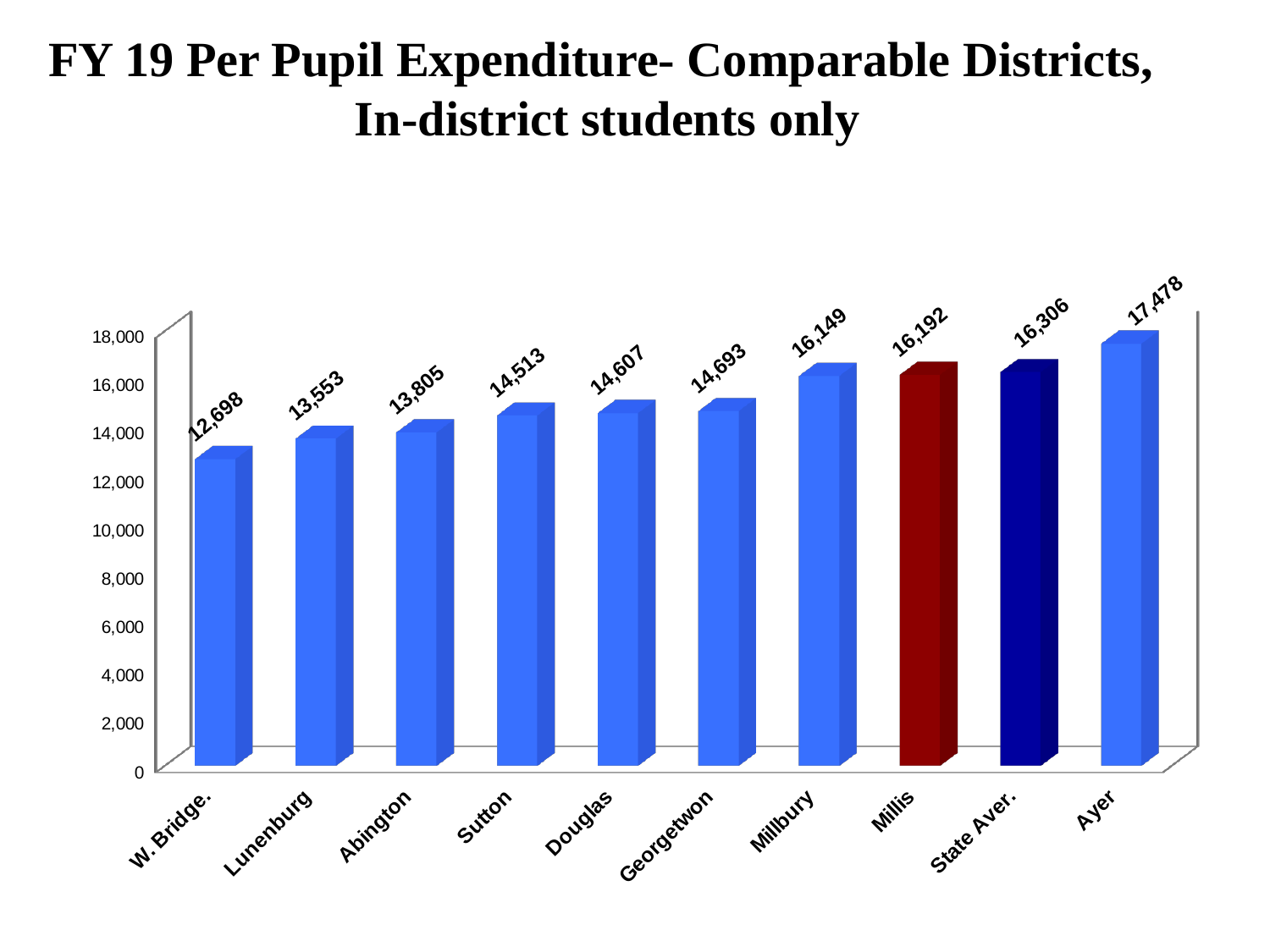
Which is larger, the value for Sutton or the value for Douglas? Douglas What is the per pupil expenditure for Millis? 16,192 What is the difference between the values for Ayer and Millis? 1,286 Is the value for Lunenburg greater or less than 14,000? less What is the difference between the State Aver. value and the Millis value? 114 What kind of chart is shown on the slide? bar chart Which district has the highest per pupil expenditure? Ayer What is the value shown for State Aver.? 16,306 Which district has the lowest per pupil expenditure? W. Bridge. How many bars are shown in the chart? 10 What is the value shown for W. Bridge.? 12,698 Which bar is coloured dark red? Millis